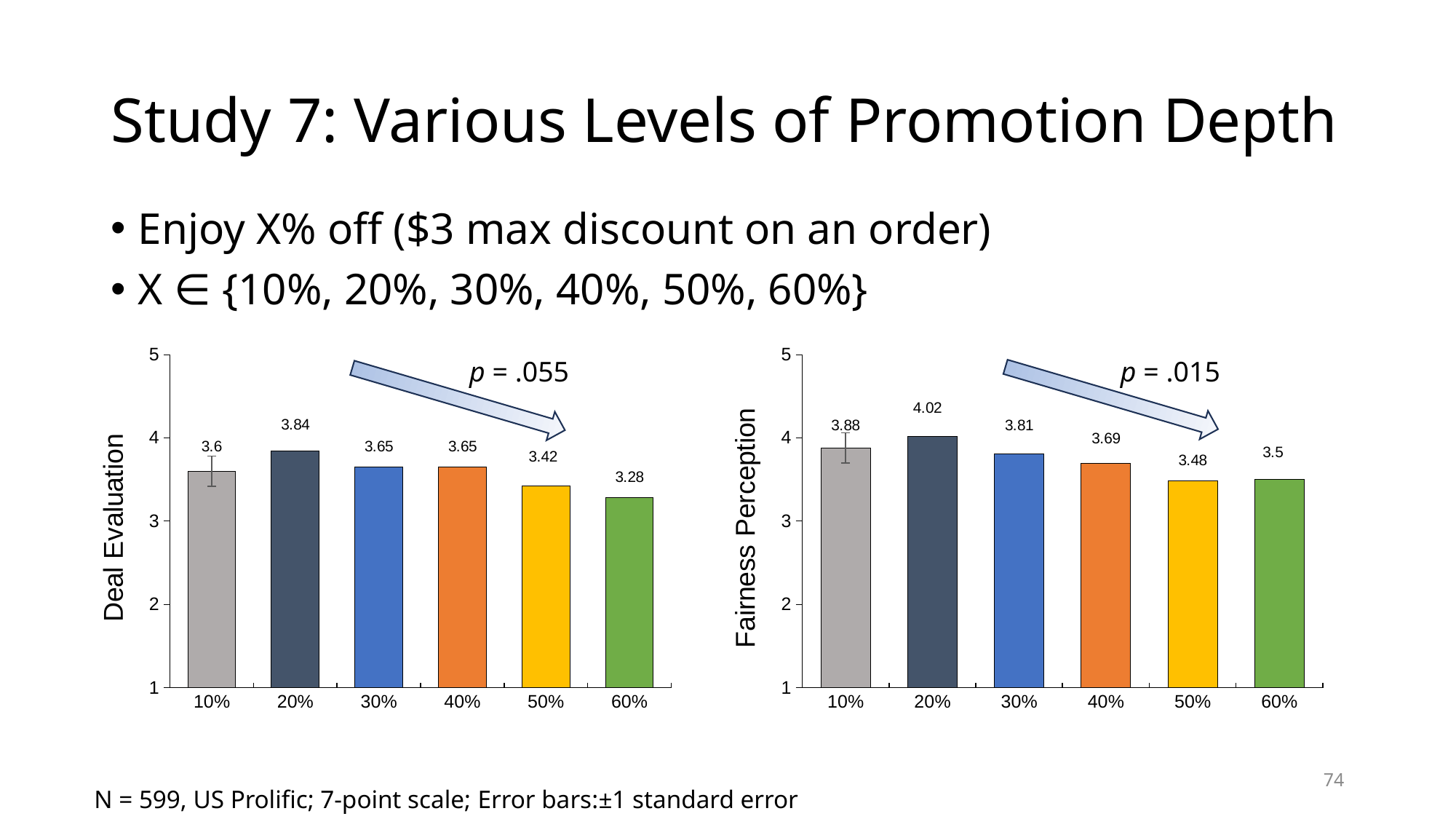
In the right chart (Fairness Perception), what is the difference between the values for 20% and 50%? 0.54 In the right chart (Fairness Perception), which discount level has the highest value? 20% What kind of chart is the right chart (Fairness Perception)? bar chart In the left chart (Deal Evaluation), is the value for 20% greater or less than 4? less In the left chart (Deal Evaluation), do the values generally rise or fall as the discount level increases from 20% to 60%? fall In the right chart (Fairness Perception), what is the value for 40%? 3.69 In the left chart (Deal Evaluation), what is the value for 20%? 3.84 In the right chart (Fairness Perception), which is larger, the value for 10% or the value for 30%? 10% In the left chart (Deal Evaluation), which discount level has the lowest value? 60% In the left chart (Deal Evaluation), what is the difference between the values for 20% and 60%? 0.56 How many discount levels are shown on the x axis of the left chart (Deal Evaluation)? 6 What p-value is shown on the right chart (Fairness Perception)? p = .015